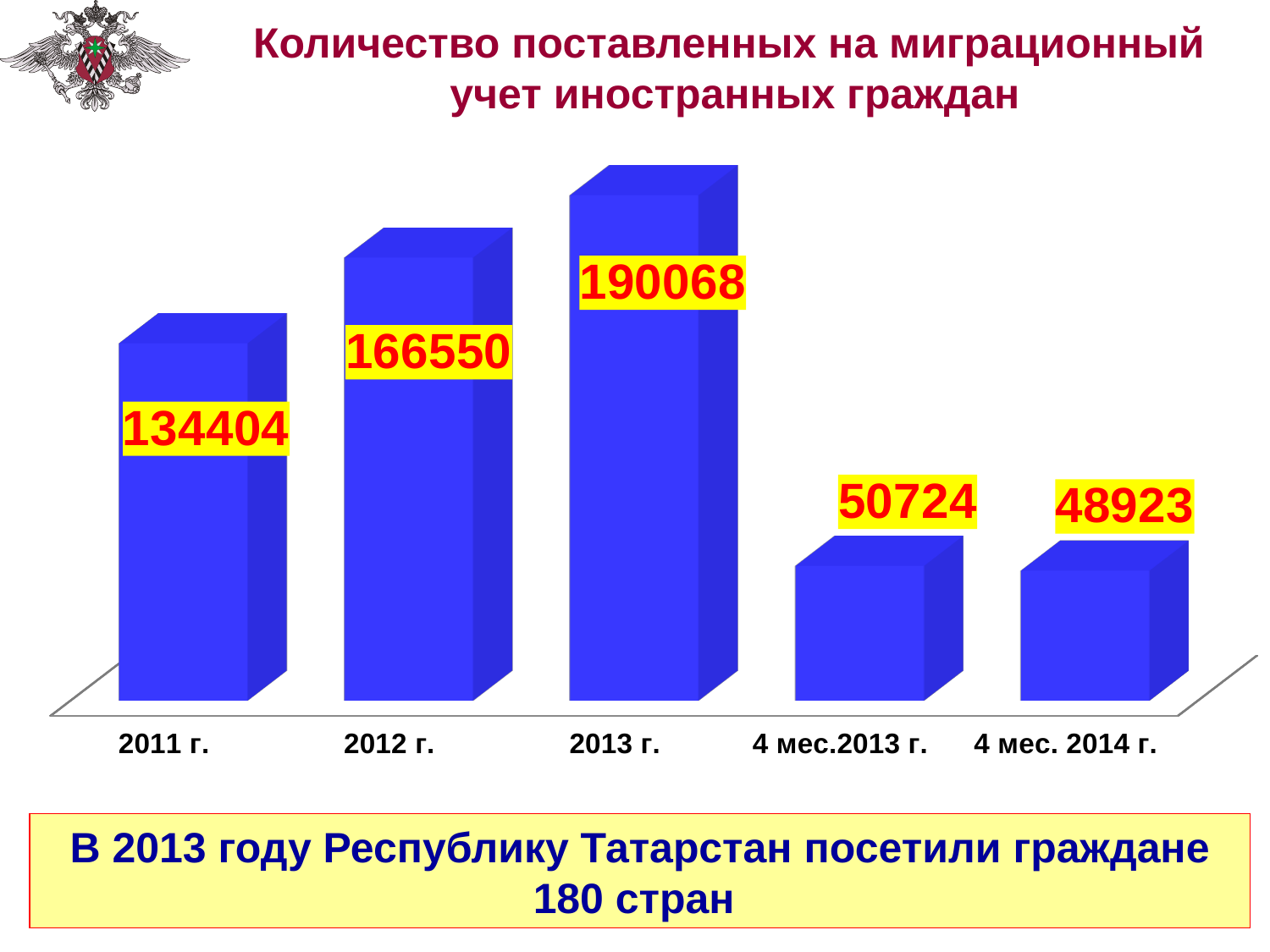
What is the value for 4 мес. 2014 г.? 48923 What is the title of the chart? Количество поставленных на миграционный учет иностранных граждан Do the values rise or fall from 2011 г. to 2013 г.? Rise What is the difference between the values for 2013 г. and 2012 г.? 23518 What is the difference between the values for 4 мес.2013 г. and 4 мес. 2014 г.? 1801 How many categories are shown on the chart? 5 What kind of chart is shown on the slide? Bar chart What is the value for 2013 г.? 190068 Which is larger, the value for 4 мес.2013 г. or the value for 4 мес. 2014 г.? 4 мес.2013 г. Which category has the highest value? 2013 г. Which category has the lowest value? 4 мес. 2014 г. What is the value for 2011 г.? 134404